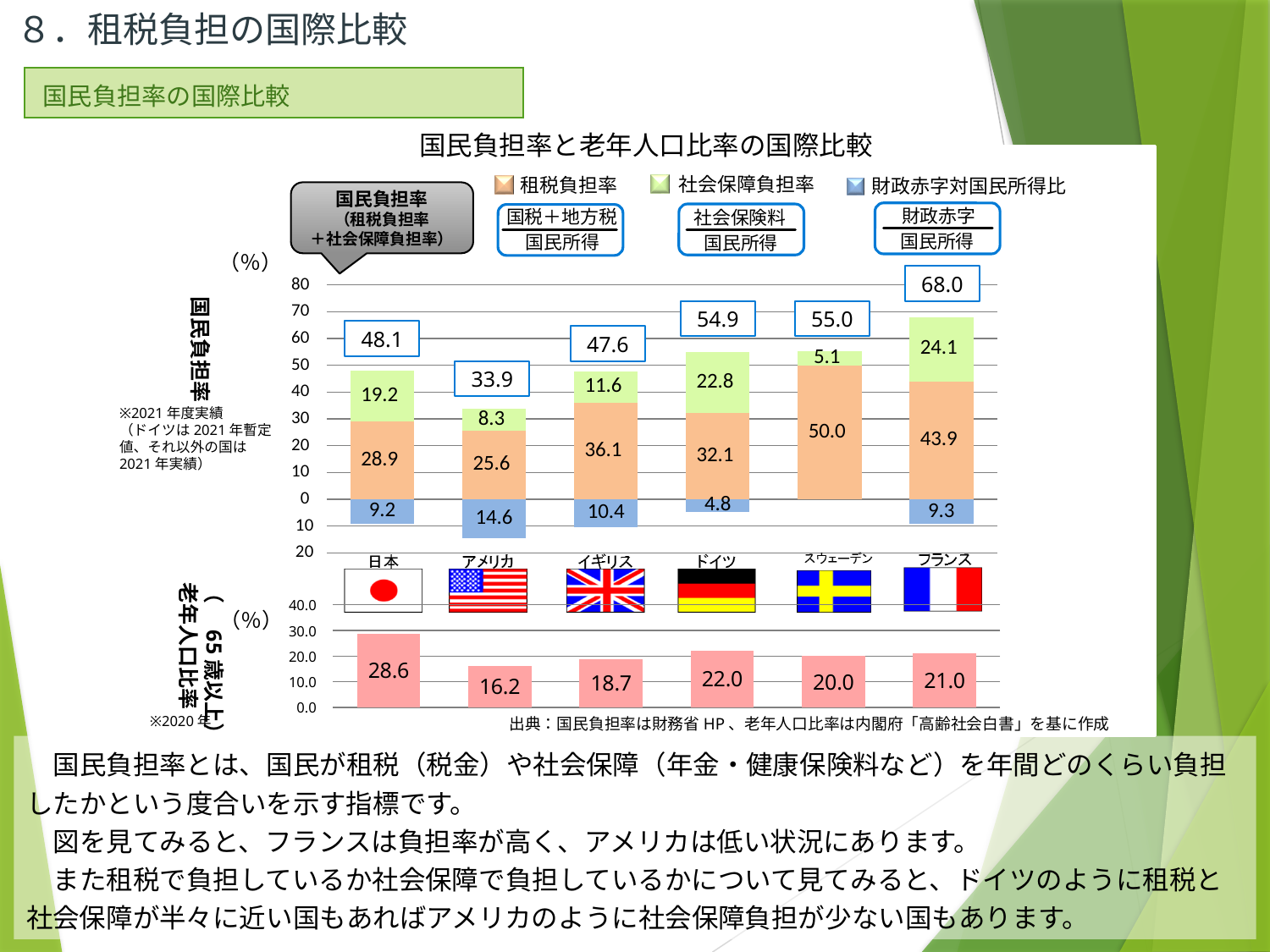
上の国民負担率のグラフで、ドイツの社会保障負担率とイギリスの社会保障負担率ではどちらが大きいですか？ ドイツ 上の国民負担率のグラフで、国民負担率が最も低い国はどこですか？ アメリカ 下の老年人口比率のグラフで、日本の老年人口比率はいくらですか？ 28.6 上の国民負担率のグラフで、国民負担率が最も高い国はどこですか？ フランス 下の老年人口比率のグラフで、老年人口比率が最も低い国はどこですか？ アメリカ 上の国民負担率のグラフで、フランスの国民負担率はいくらですか？ 68.0 上の国民負担率のグラフで、フランスと日本の国民負担率の差はいくらですか？ 19.9 上の国民負担率のグラフで、凡例にはいくつの系列がありますか？ 3 上の国民負担率のグラフで、アメリカの租税負担率はいくらですか？ 25.6 下の老年人口比率のグラフは、どの種類のグラフですか？ 棒グラフ 上の国民負担率のグラフで、スウェーデンの財政赤字対国民所得比の値は表示されていますか？ いいえ 下の老年人口比率のグラフには、いくつの国が示されていますか？ 6